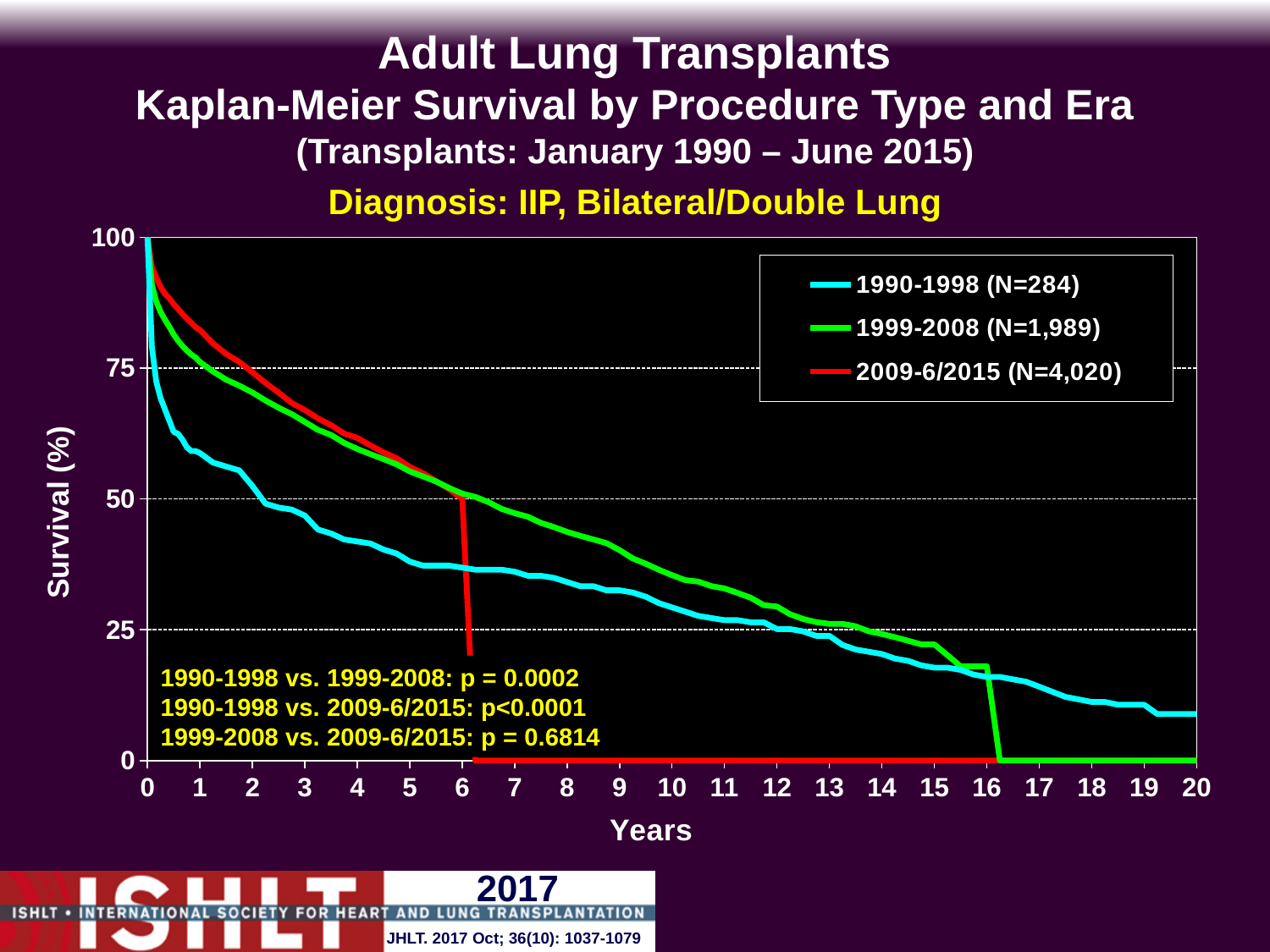
Is the survival value for the 1999-2008 group at year 10 greater or less than 25? greater Is the survival value for the 2009-6/2015 group at year 1 greater or less than 75? greater According to the legend, what is the N for the 1999-2008 group? N=1,989 Do the survival curves rise or fall as the years increase? fall At year 2, which group has higher survival: 1990-1998 or 1999-2008? 1999-2008 What p-value is shown for the comparison of 1999-2008 vs. 2009-6/2015? p = 0.6814 Is the survival value for the 1990-1998 group at year 1 greater or less than 50? greater How many series does the legend list? 3 What kind of chart is shown on the slide? line chart At year 3, which group has the lowest survival? 1990-1998